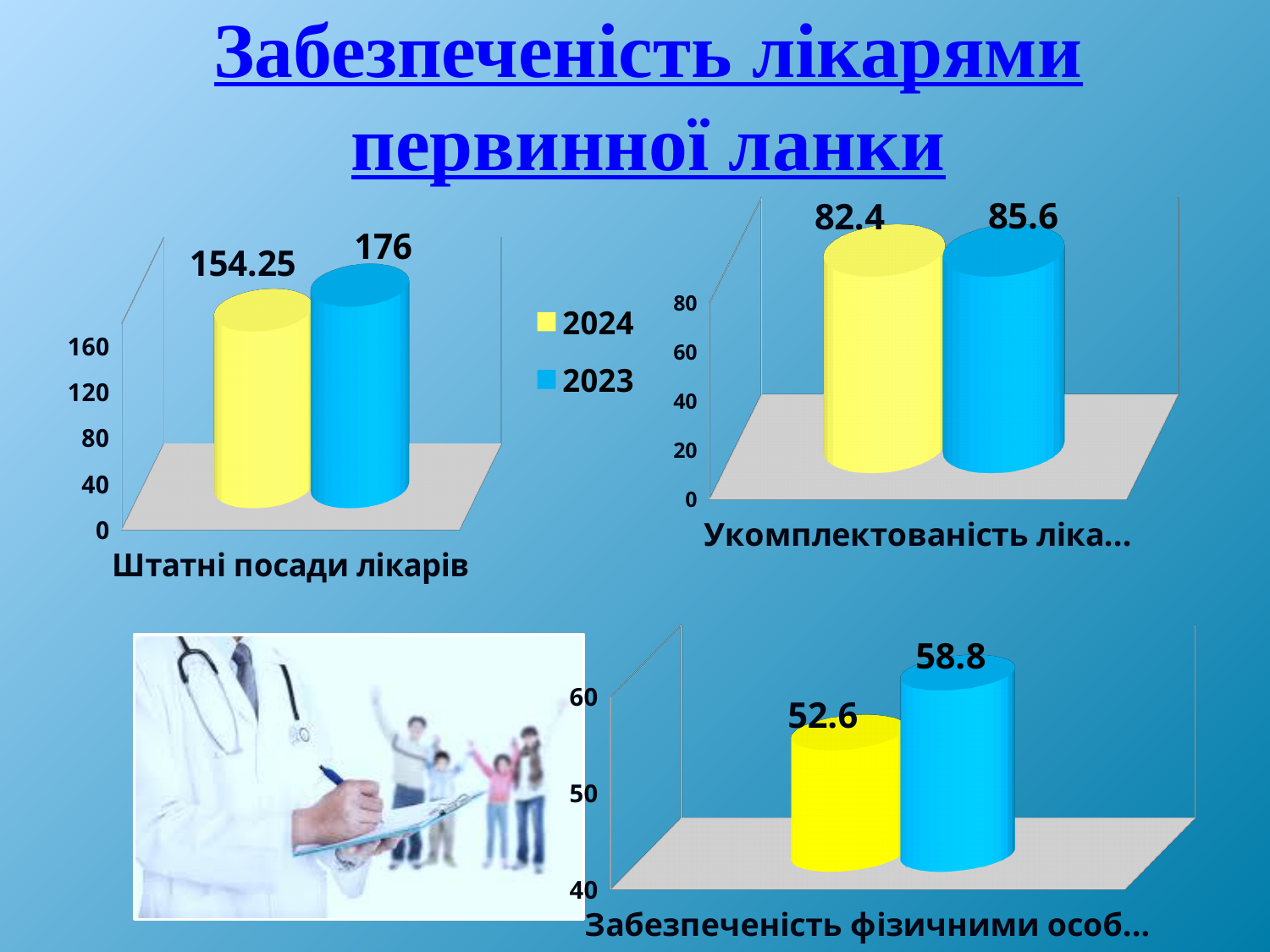
In the top-left chart (Штатні посади лікарів), what is the value for 2024? 154.25 In the top-left chart (Штатні посади лікарів), what is the value for 2023? 176 In the top-right chart, what is the value of the blue bar? 85.6 In the top-left chart (Штатні посади лікарів), what is the difference between the 2023 and 2024 values? 21.75 In the top-right chart, what is the difference between the blue bar and the yellow bar? 3.2 What type of chart is the top-left chart (Штатні посади лікарів)? bar chart In the bottom-right chart, which bar is higher, the yellow one or the blue one? blue In the bottom-right chart, what is the value of the blue bar? 58.8 How many series does the legend on the slide list? 2 In the top-right chart, what is the value of the yellow bar? 82.4 In the bottom-right chart, what is the value of the yellow bar? 52.6 In the top-left chart (Штатні посади лікарів), which year has the larger value, 2023 or 2024? 2023